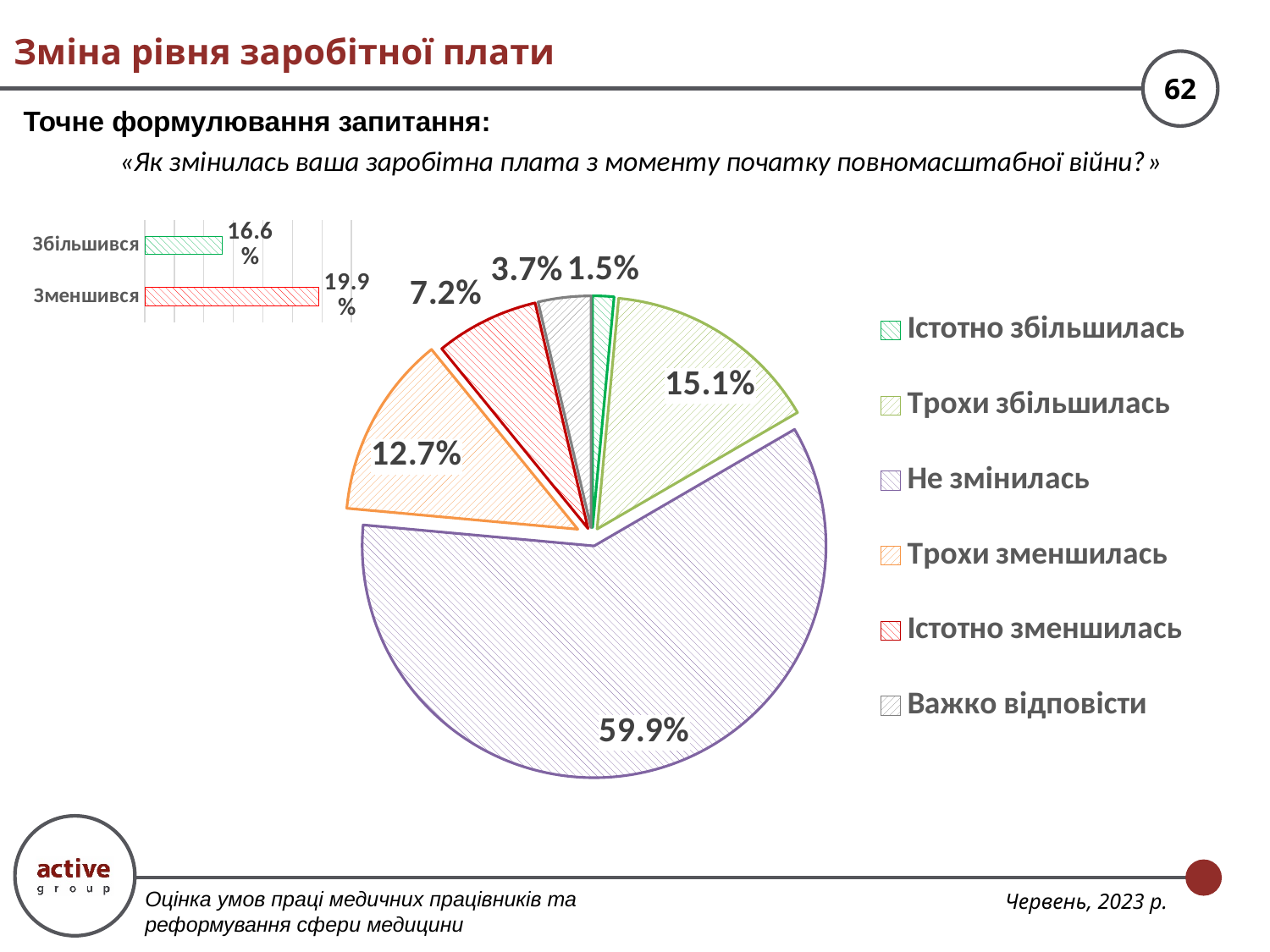
In the pie chart, what is the difference between «Трохи збільшилась» and «Трохи зменшилась»? 2.4% In the small bar chart at the top left, what is the value for «Зменшився»? 19.9% How many categories does the pie chart legend list? 6 In the pie chart, what is the value for «Трохи зменшилась»? 12.7% In the pie chart, which is larger: «Істотно зменшилась» or «Важко відповісти»? Істотно зменшилась What type of chart is the small chart at the top left of the slide? Bar chart In the small bar chart at the top left, what is the value for «Збільшився»? 16.6% In the pie chart, which category has the smallest share? Істотно збільшилась In the pie chart, what is the value for «Трохи збільшилась»? 15.1% In the pie chart, which category has the largest share? Не змінилась In the pie chart, what is the value for «Істотно зменшилась»? 7.2% In the pie chart, what share of respondents answered «Не змінилась»? 59.9%